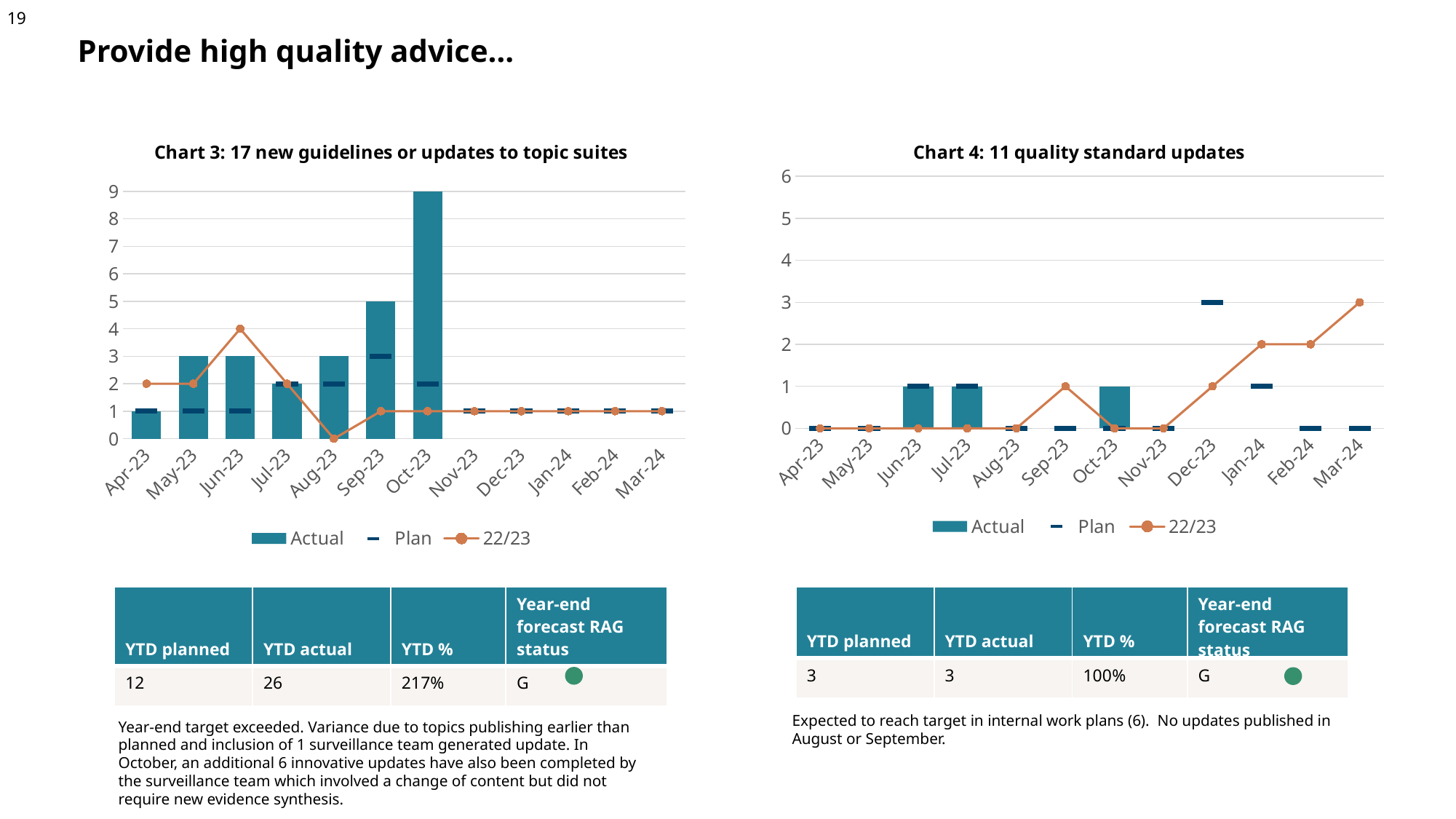
In Chart 3, what is the Actual value for Oct-23? 9 In Chart 3, what is the 22/23 value for Jun-23? 4 In Chart 4, what is the Plan value for Dec-23? 3 In Chart 4, which month has the highest 22/23 value? Mar-24 In Chart 3, what is the Actual value for Sep-23? 5 In Chart 4, how many months are shown on the x axis? 12 What type of chart is Chart 4? Bar chart with line In Chart 3, is the Actual value for Oct-23 greater or less than 8? greater In Chart 3, what is the difference between the Actual value for Oct-23 and the Actual value for Sep-23? 4 In Chart 3, which month has the highest Actual bar? Oct-23 In Chart 3, how many series does the legend list? 3 In Chart 4, what is the 22/23 value for Mar-24? 3